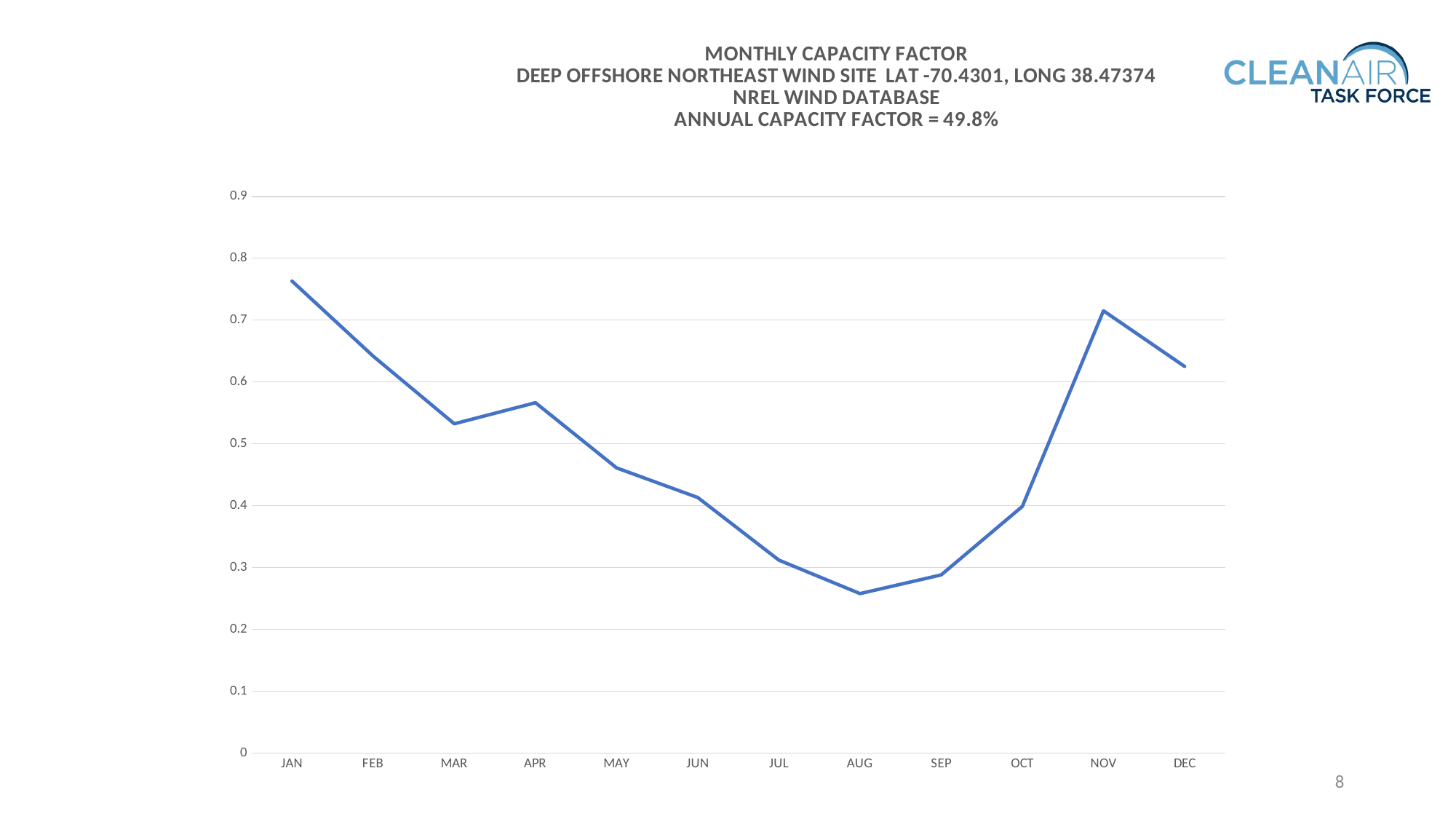
Is the value for NOV greater or less than 0.6? greater Do the values rise or fall from JAN to MAR? fall Which month has a higher capacity factor, NOV or DEC? NOV Which month has the lowest capacity factor? AUG What annual capacity factor is stated in the chart title? 49.8% Is the value for JAN greater or less than 0.7? greater Which month has the highest capacity factor? JAN Is the value for AUG greater or less than 0.3? less Do the values rise or fall from AUG to NOV? rise What kind of chart is shown on the slide? line chart How many months are plotted along the x axis? 12